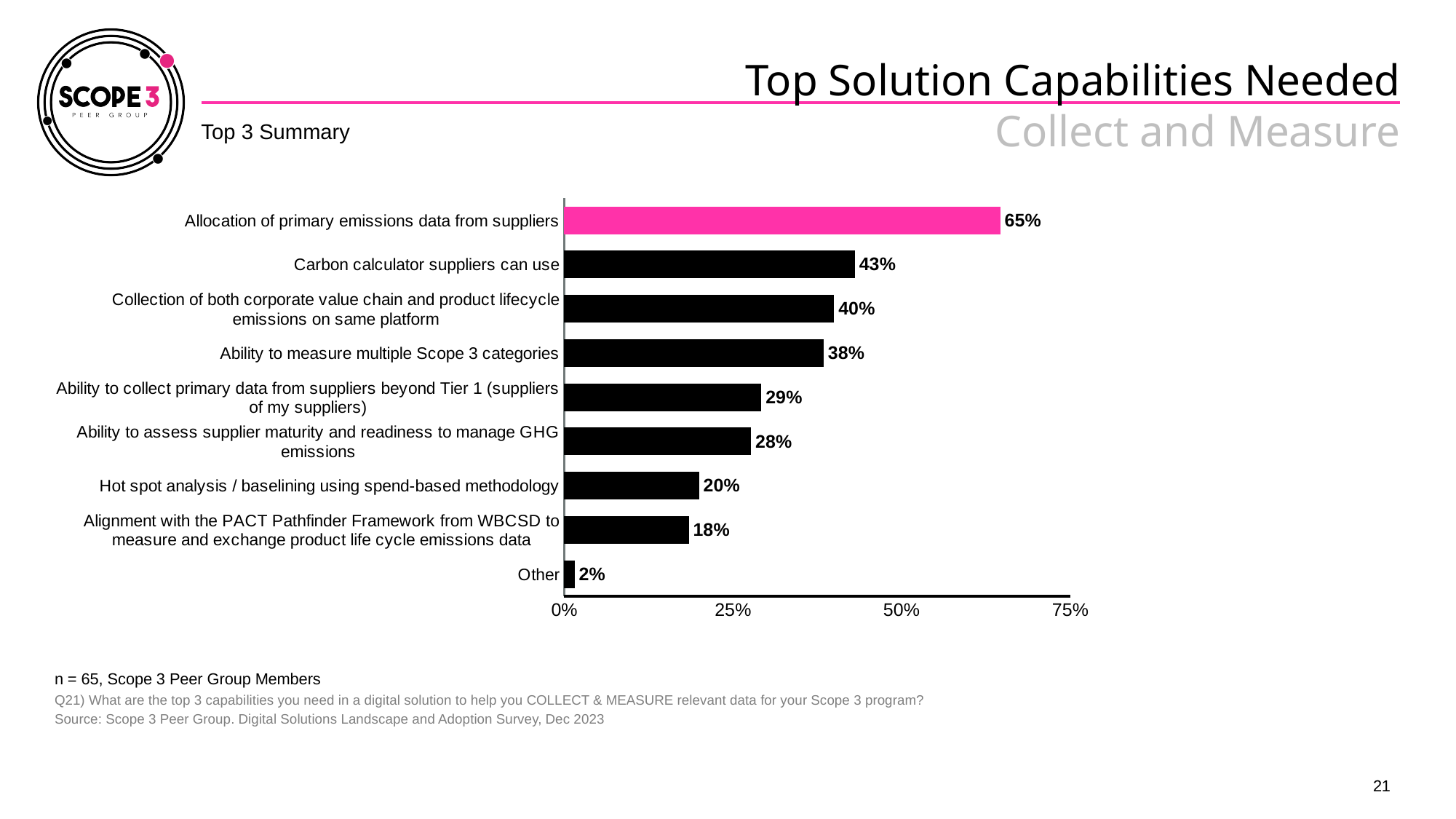
Which is larger: 'Ability to measure multiple Scope 3 categories' or 'Ability to collect primary data from suppliers beyond Tier 1 (suppliers of my suppliers)'? Ability to measure multiple Scope 3 categories What percentage is shown for 'Hot spot analysis / baselining using spend-based methodology'? 20% What kind of chart is shown on the slide? Bar chart What is the value for 'Alignment with the PACT Pathfinder Framework from WBCSD to measure and exchange product life cycle emissions data'? 18% What is the difference between 'Allocation of primary emissions data from suppliers' and 'Carbon calculator suppliers can use'? 22% Which capability has the highest percentage? Allocation of primary emissions data from suppliers Which bar is coloured pink rather than black? Allocation of primary emissions data from suppliers Which category has the lowest percentage? Other Is the value for 'Collection of both corporate value chain and product lifecycle emissions on same platform' greater or less than 50%? less What percentage is shown for 'Allocation of primary emissions data from suppliers'? 65% What is the value for 'Carbon calculator suppliers can use'? 43% How many categories are shown in the chart? 9